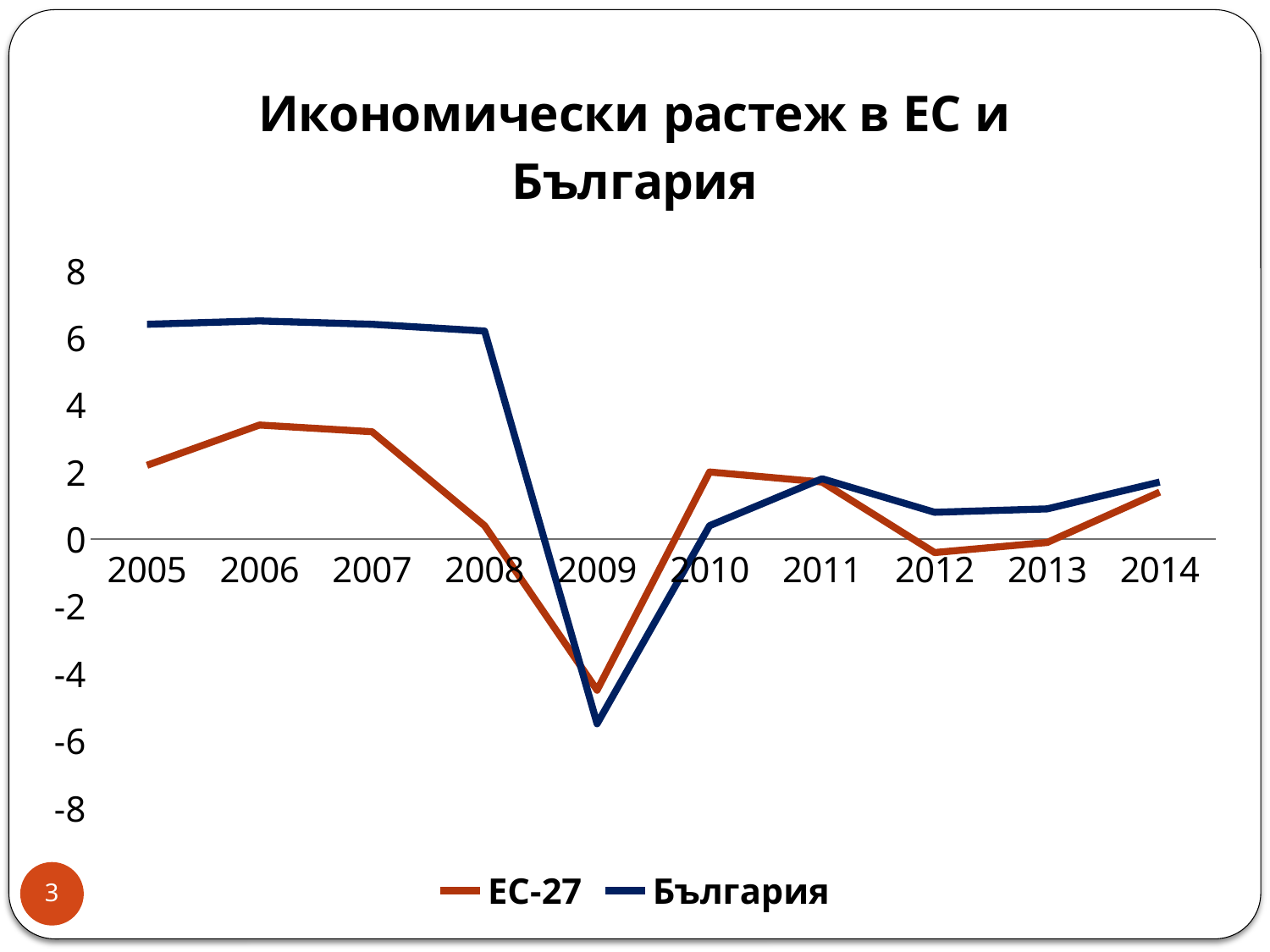
In which year does the ЕС-27 series reach its lowest value? 2009 How many series does the legend list? 2 Does the България series rise or fall from 2008 to 2009? fall Is the value for България in 2009 greater or less than -4? less How many years are plotted along the x axis? 10 In 2010, which series has the higher value, ЕС-27 or България? ЕС-27 Is the value for България in 2005 greater or less than 4? greater What colour is the line for България in the legend? dark blue Is the value for ЕС-27 in 2009 greater or less than -2? less In which year does the България series reach its lowest value? 2009 What kind of chart is shown on the slide? line chart In 2008, which series has the higher value, ЕС-27 or България? България